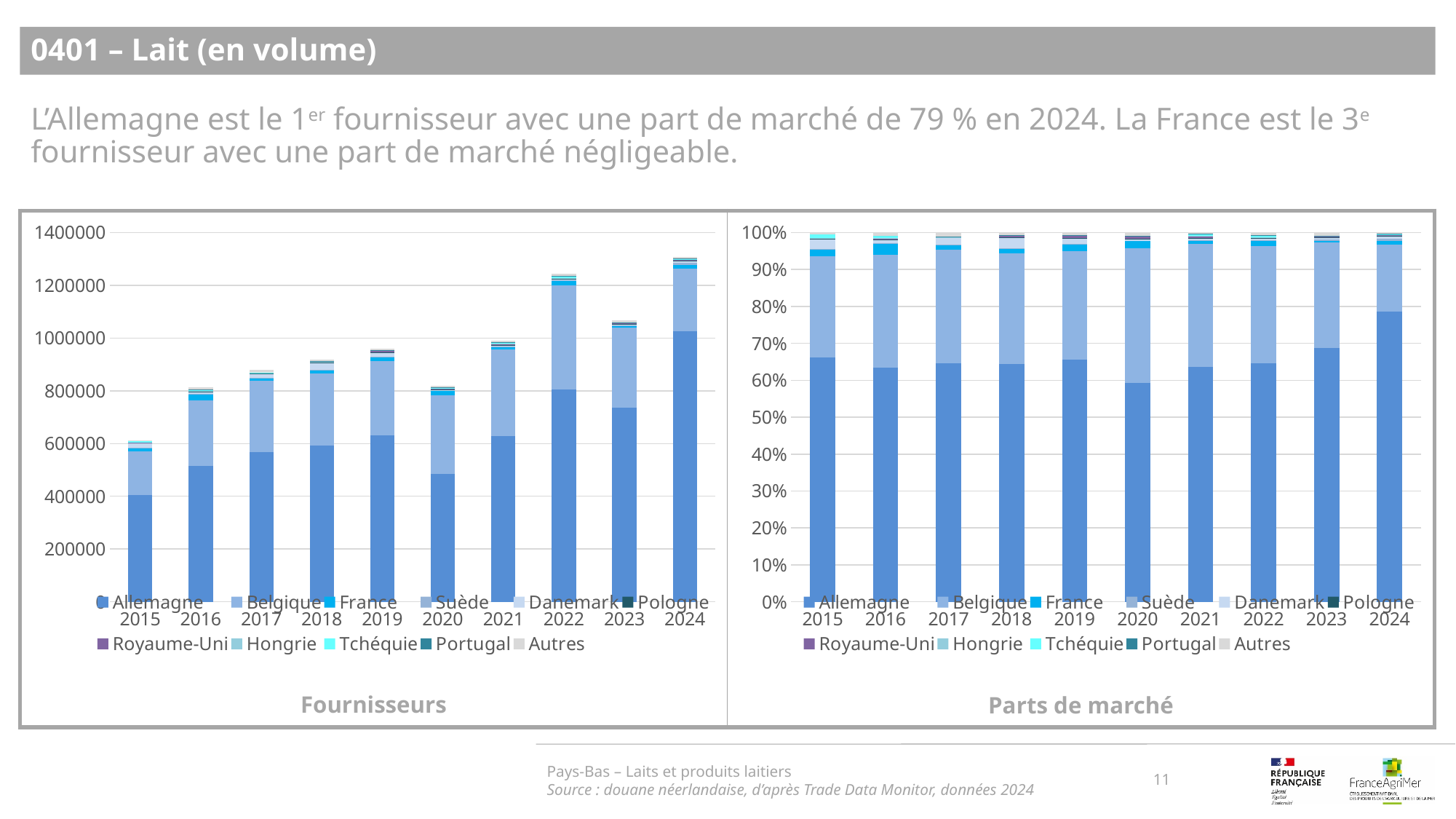
What kind of chart is the 'Fournisseurs' chart on the left? Stacked bar chart In the 'Fournisseurs' chart, is the total bar for 2015 greater or less than 800000? less Which series is shown at the bottom of each stacked bar in both charts? Allemagne In the 'Fournisseurs' chart, which year has the tallest total bar? 2024 In the 'Fournisseurs' chart, which year has the shortest total bar? 2015 In the 'Fournisseurs' chart, is the total bar for 2022 or for 2023 larger? 2022 In the 'Parts de marché' chart, is the share of Allemagne in 2024 greater or less than 70%? greater In the 'Parts de marché' chart, in which year is the share of Allemagne the lowest? 2020 How many series does the legend of the 'Fournisseurs' chart list? 11 In the 'Fournisseurs' chart, is the total bar for 2024 greater or less than 1200000? greater How many years are shown on the x axis of the 'Parts de marché' chart? 10 In the 'Parts de marché' chart, is the share of Allemagne larger in 2015 or in 2024? 2024